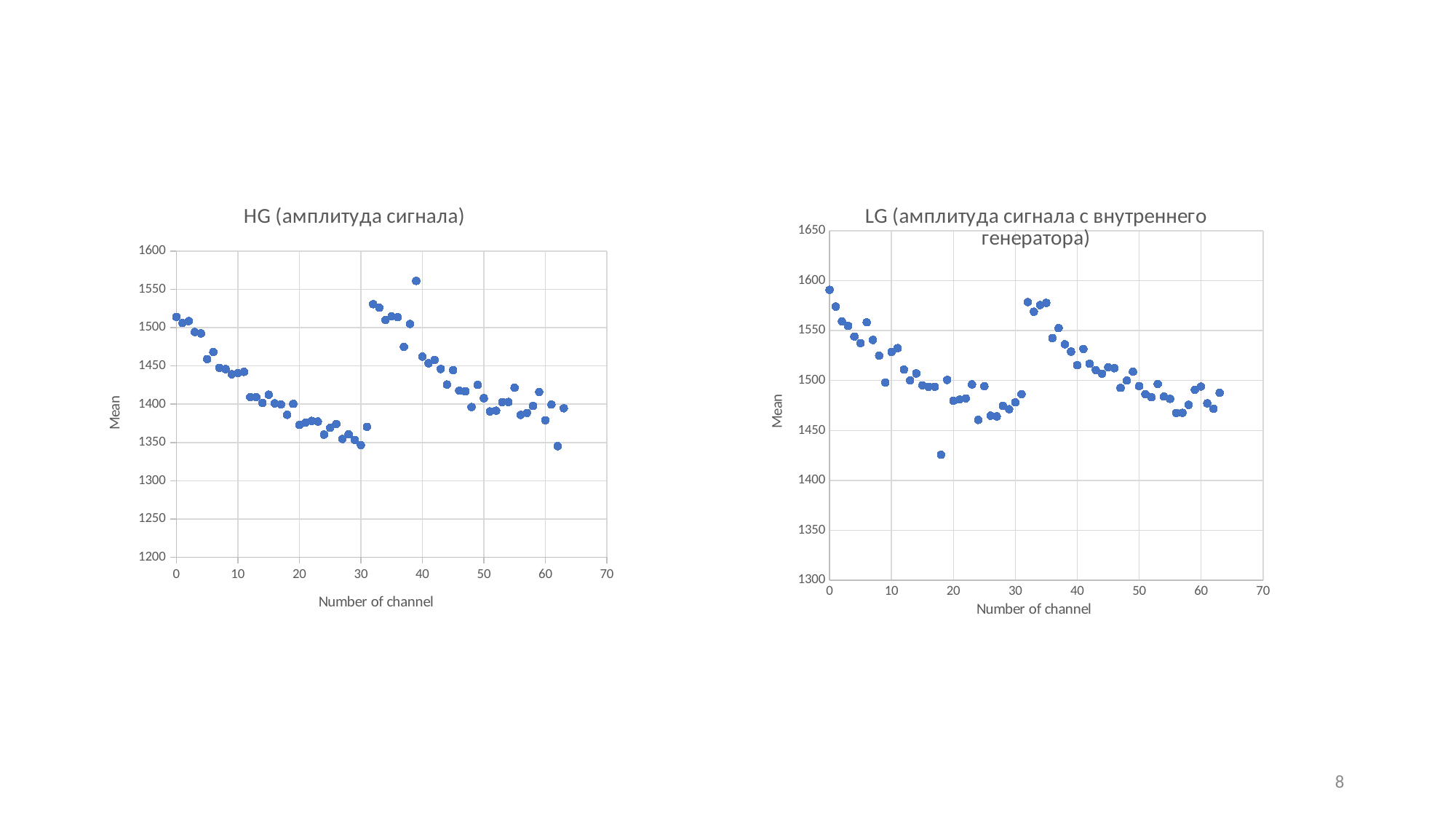
What kind of chart is the LG (амплитуда сигнала с внутреннего генератора) chart? scatter chart What kind of chart is the HG (амплитуда сигнала) chart? scatter chart In the HG (амплитуда сигнала) chart, do the values rise or fall from channel 0 to channel 30? fall In the LG (амплитуда сигнала с внутреннего генератора) chart, is the value at channel 18 greater or less than 1450? less What is the x-axis title of the LG (амплитуда сигнала с внутреннего генератора) chart? Number of channel In the LG (амплитуда сигнала с внутреннего генератора) chart, do the values rise or fall from channel 32 to channel 63? fall In the HG (амплитуда сигнала) chart, is the value at channel 0 greater or less than 1500? greater In the HG (амплитуда сигнала) chart, is the value at channel 39 greater or less than 1550? greater In the HG (амплитуда сигнала) chart, which is larger: the value at channel 39 or the value at channel 0? channel 39 What is the y-axis title of the HG (амплитуда сигнала) chart? Mean